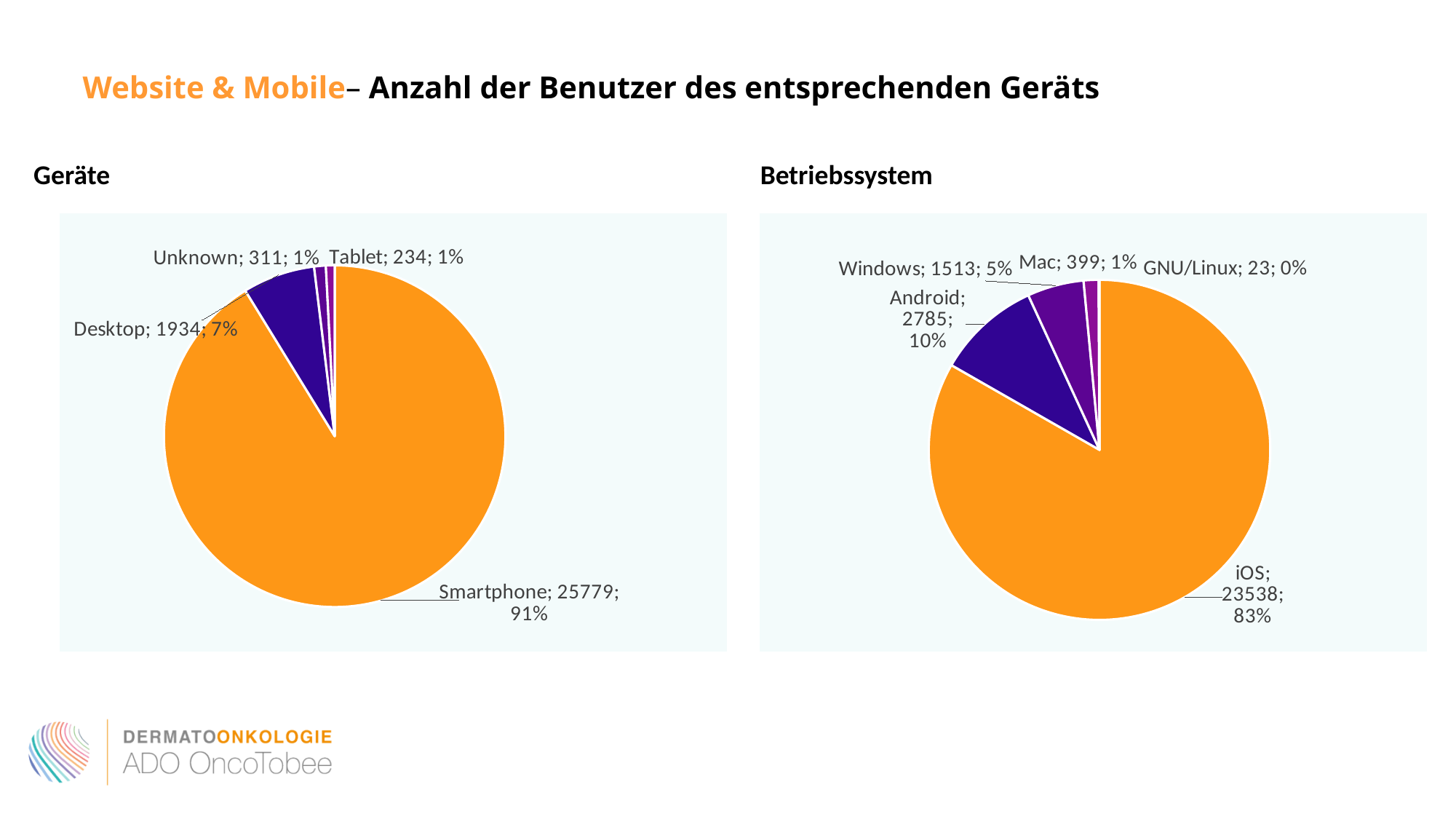
What kind of chart is the Geräte chart? Pie chart In the Geräte chart, which category has the smallest value? Tablet In the Geräte chart, what is the difference between the Desktop and Unknown values? 1623 In the Betriebssystem chart, which is larger, Windows or Mac? Windows In the Betriebssystem chart, what share of the pie does iOS have? 83% In the Betriebssystem chart, how many users are shown for Android? 2785 In the Geräte chart, how many users are shown for Smartphone? 25779 In the Geräte chart, how many categories are shown? 4 In the Betriebssystem chart, which category has the largest value? iOS In the Geräte chart, what share of the pie does Desktop have? 7% In the Betriebssystem chart, what is the difference between the Android and Windows values? 1272 In the Betriebssystem chart, how many categories are shown? 5